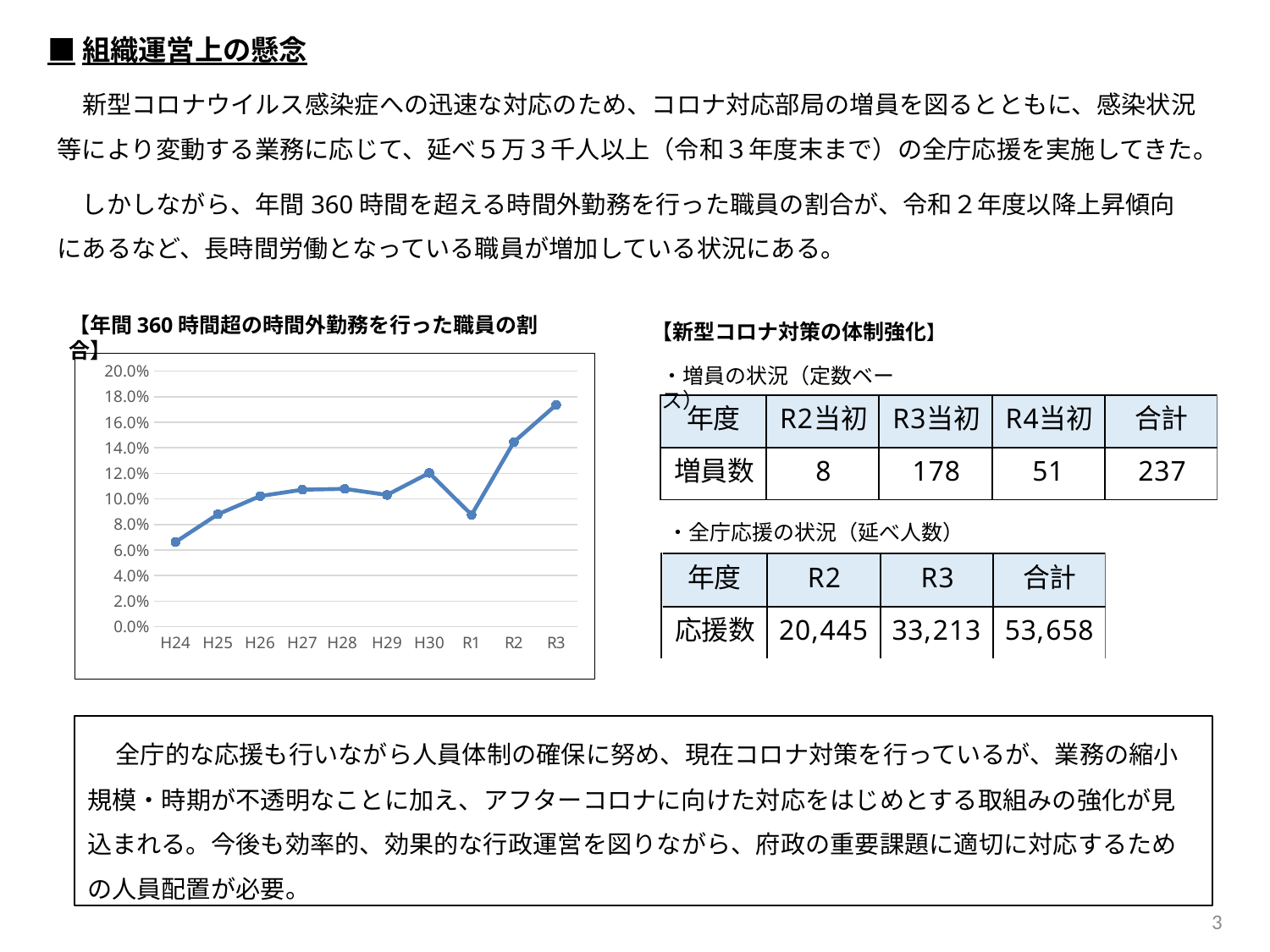
How many fiscal years are plotted on the x axis of the chart? 10 Is the value for R1 greater or less than 10.0%? less What is the title of the chart? 年間360時間超の時間外勤務を行った職員の割合 Which fiscal year has the lowest value in the chart? H24 Is the value for R3 greater or less than 16.0%? greater Which is larger, the value for H30 or the value for R1? H30 Which fiscal year has the highest value in the chart? R3 Do the values rise or fall from R1 to R3? rise Is the value for R2 greater or less than 12.0%? greater Which is larger, the value for R2 or the value for H30? R2 What kind of chart is shown on the slide? line chart